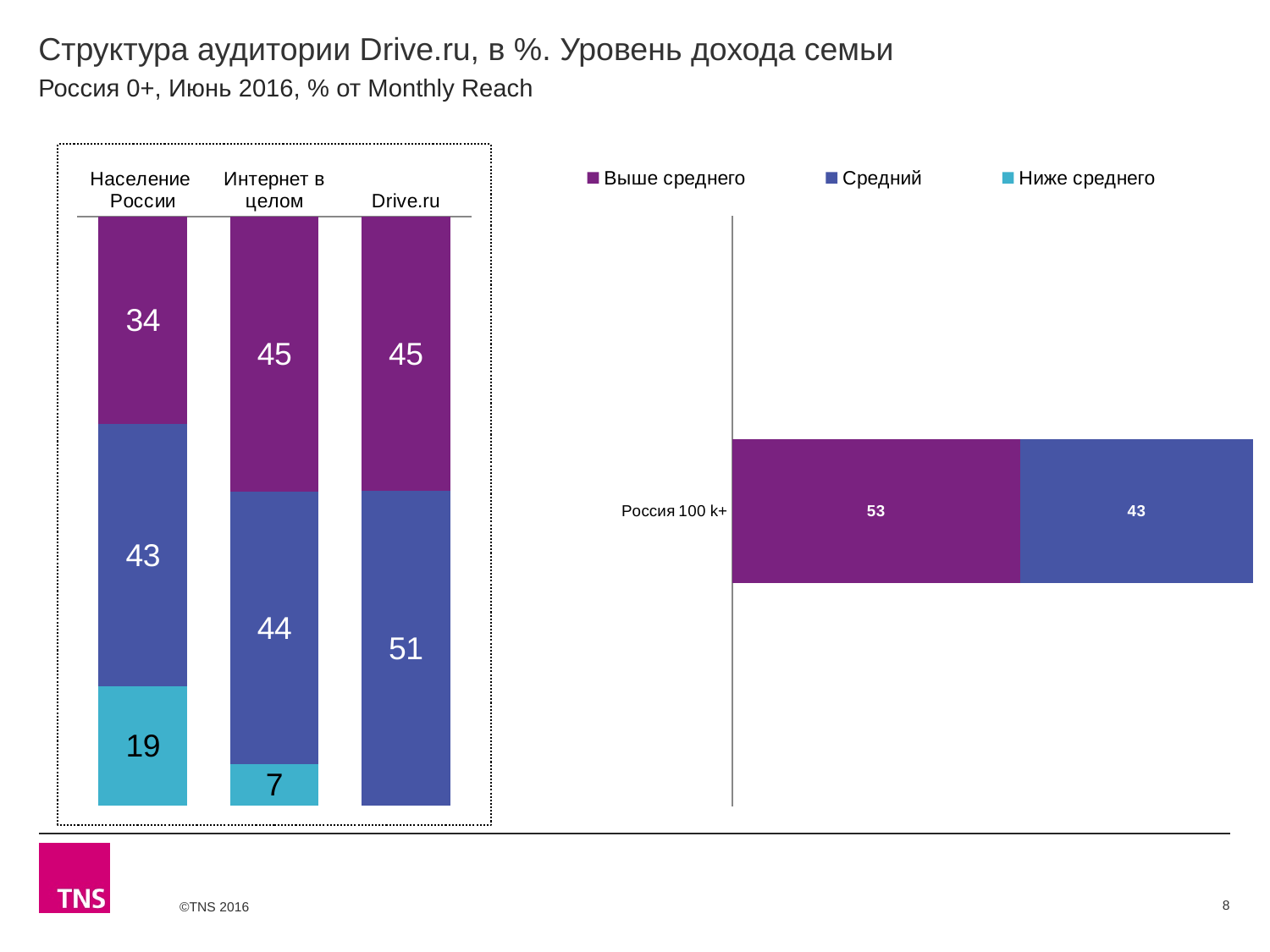
In the left chart, which category has the lowest Ниже среднего value among those with a printed label? Интернет в целом In the right chart, what is the difference between the Выше среднего and Средний values for Россия 100 k+? 10 In the right chart, what is the value of the Выше среднего segment for Россия 100 k+? 53 In the left chart, what is the value of the Средний segment for Drive.ru? 51 What type of chart is the right chart? Stacked bar chart In the left chart, which category has the highest Средний value? Drive.ru In the left chart, what is the difference between the Ниже среднего values for Население России and Интернет в целом? 12 How many categories are shown in the left chart? 3 In the left chart, what is the value of the Выше среднего segment for Интернет в целом? 45 In the left chart, what is the value of the Ниже среднего segment for Население России? 19 How many series does the legend list? 3 In the left chart, which is larger: the Выше среднего value for Население России or for Drive.ru? Drive.ru